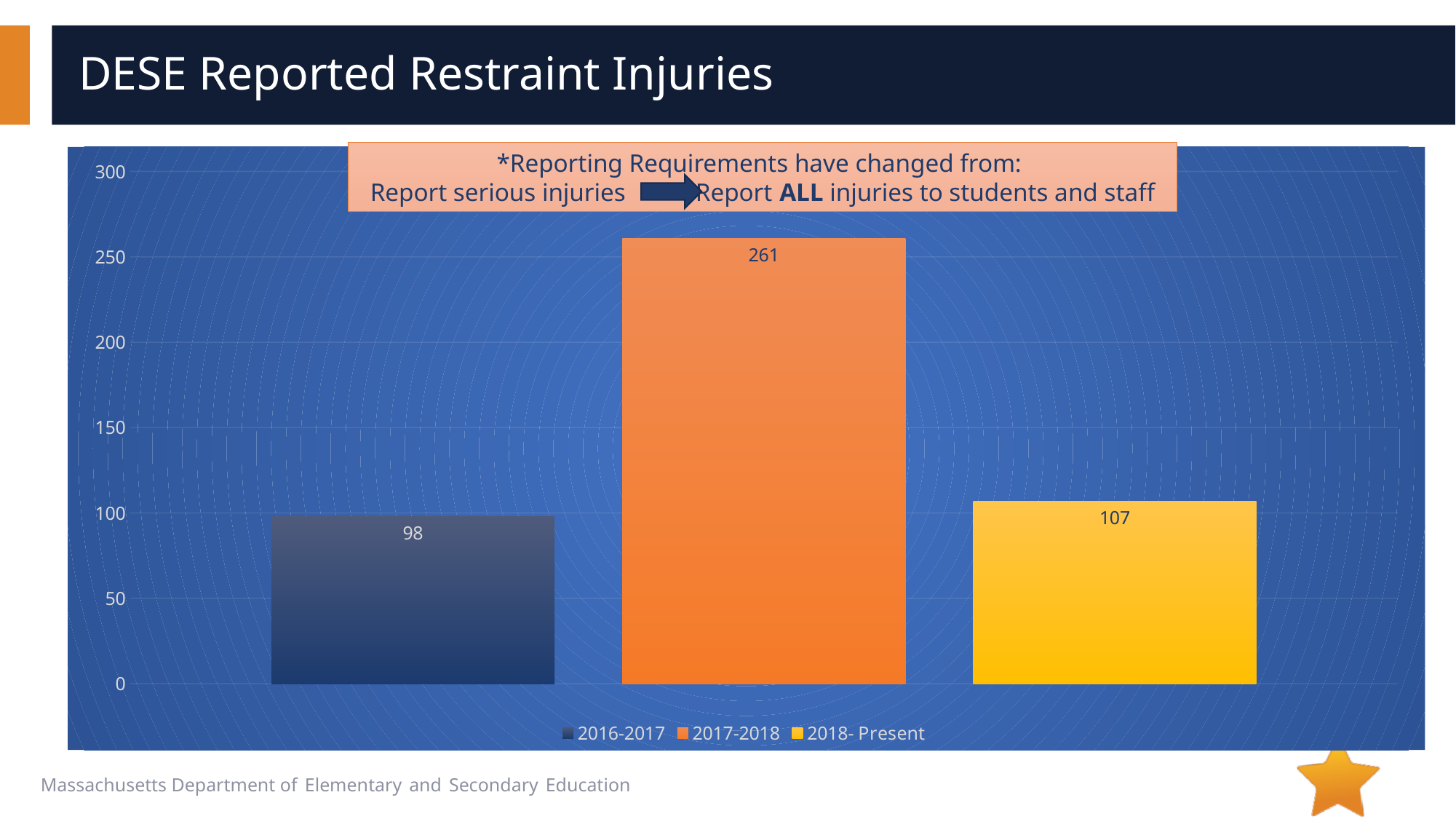
Which period has the lowest reported restraint injuries? 2016-2017 What is the difference between the 2018- Present value and the 2016-2017 value? 9 How many bars are shown in the chart? 3 What is the value for 2017-2018? 261 What is the difference between the 2017-2018 value and the 2016-2017 value? 163 How many entries does the legend list? 3 What kind of chart is shown on the slide? bar chart What is the value for 2018- Present? 107 Which is larger, the value for 2017-2018 or the value for 2018- Present? 2017-2018 Is the value for 2016-2017 greater or less than 100? less Which period has the highest reported restraint injuries? 2017-2018 What is the value for 2016-2017? 98